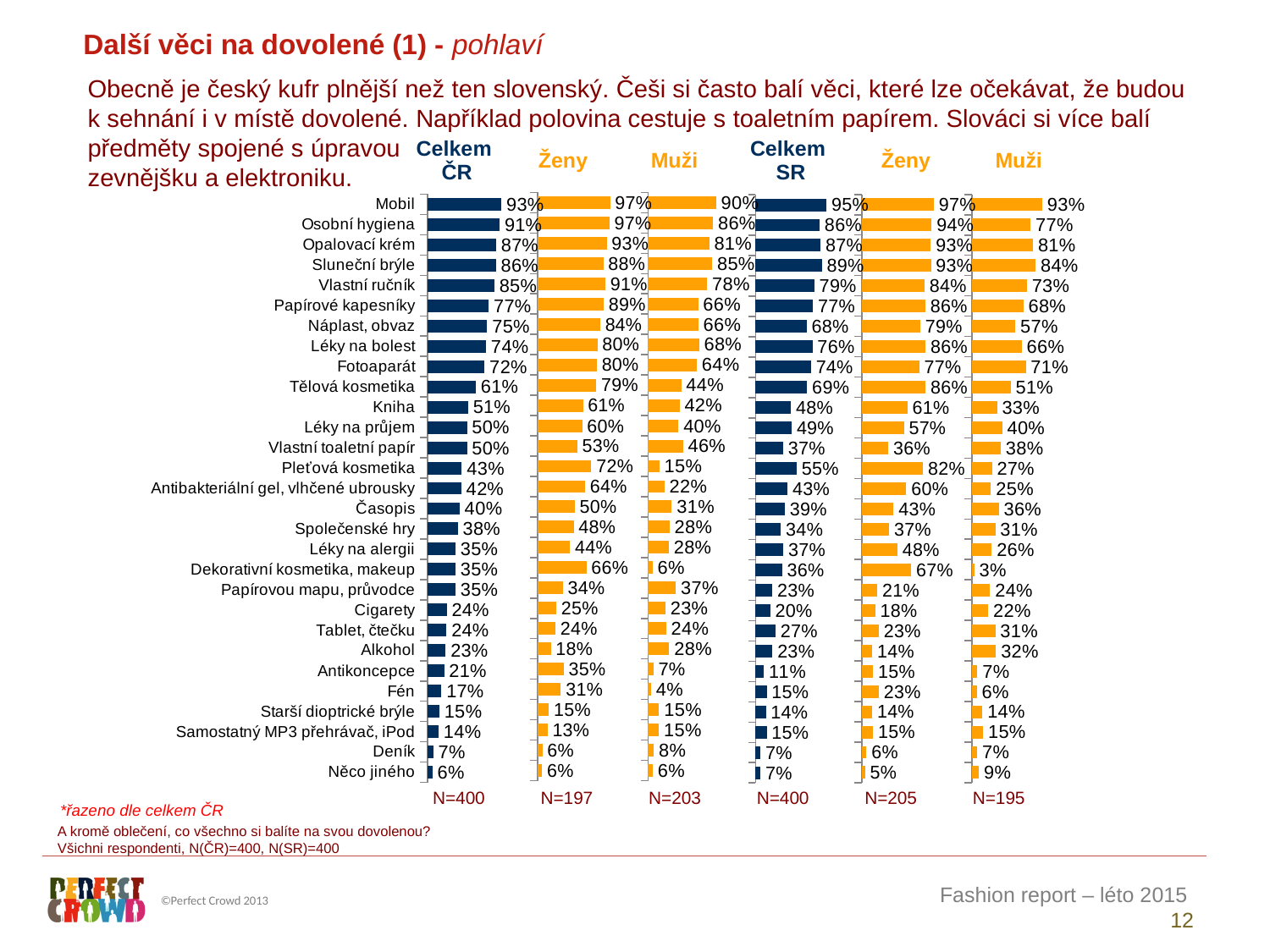
In the Celkem SR chart, which item has the highest value? Mobil What is the sample size (N) shown under the Muži ČR chart? N=203 In the Ženy SR chart, what is the value for Tělová kosmetika? 86% For Alkohol, which is larger: the Muži SR value or the Ženy SR value? Muži SR What is the difference between the Ženy ČR value and the Muži ČR value for Pleťová kosmetika? 57 percentage points In the Celkem ČR chart, what is the value for Fotoaparát? 72% What type of chart is used on this slide? Bar chart How many items (categories) are listed in each chart? 29 In the Muži ČR chart, which item has the lowest value? Fén What is the difference between the Celkem SR value and the Celkem ČR value for Mobil? 2 percentage points In the Celkem SR chart, what is the value for Antikoncepce? 11% In the Muži SR chart, what is the value for Dekorativní kosmetika, makeup? 3%